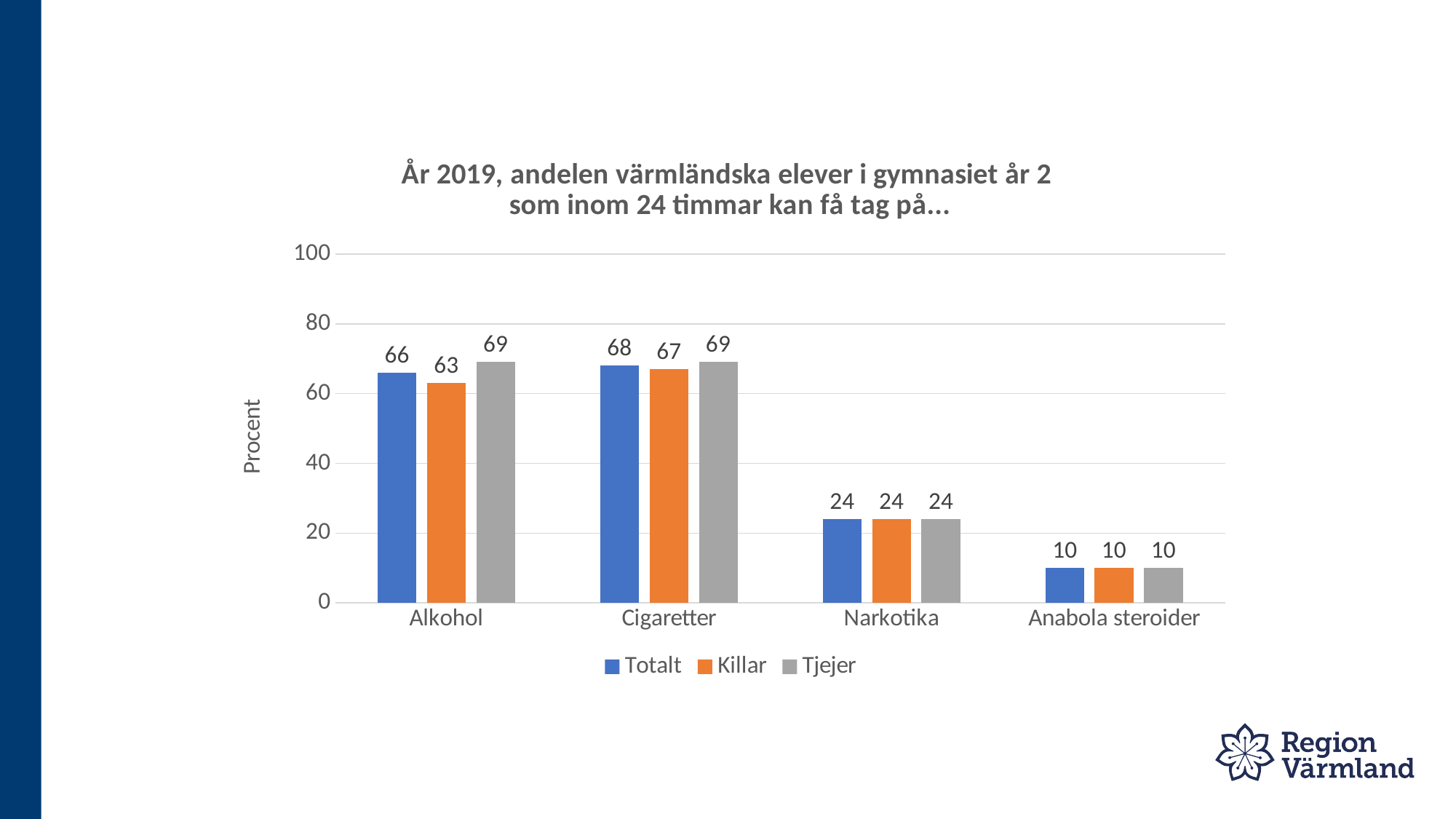
How many categories are shown on the x axis? 4 What is the value for Totalt in the Narkotika category? 24 What is the value for Tjejer in the Cigaretter category? 69 Which category has the highest value for Killar? Cigaretter Is the value for Totalt in the Cigaretter category greater or less than 60? greater Which is larger in the Alkohol category, the Totalt value or the Killar value? Totalt What is the value for Killar in the Alkohol category? 63 Which category has the lowest value for Totalt? Anabola steroider How many series does the legend list? 3 What is the difference between the Tjejer and Killar values in the Alkohol category? 6 What kind of chart is shown on the slide? bar chart What is the label of the y axis? Procent